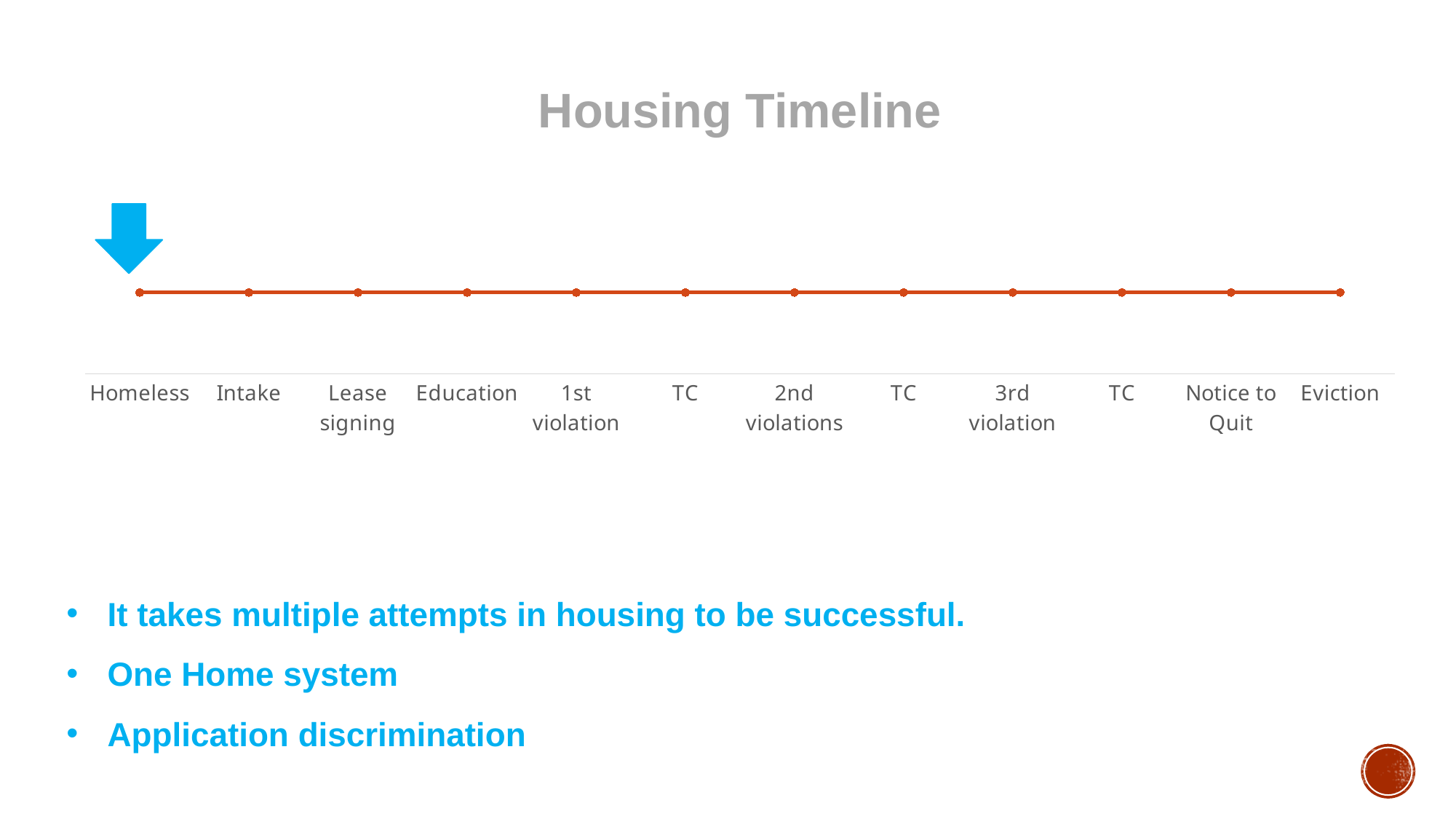
What kind of chart is shown on the slide? Line chart Do the plotted values rise, fall, or stay flat along the x axis? Stay flat Which category comes immediately after "Intake" on the x axis? Lease signing How many times does the label "TC" appear on the x axis? 3 Which category comes immediately before "Eviction" on the x axis? Notice to Quit How many points are plotted along the timeline? 12 What is the last category on the x axis? Eviction What is the first category on the x axis? Homeless What is the title of the chart? Housing Timeline